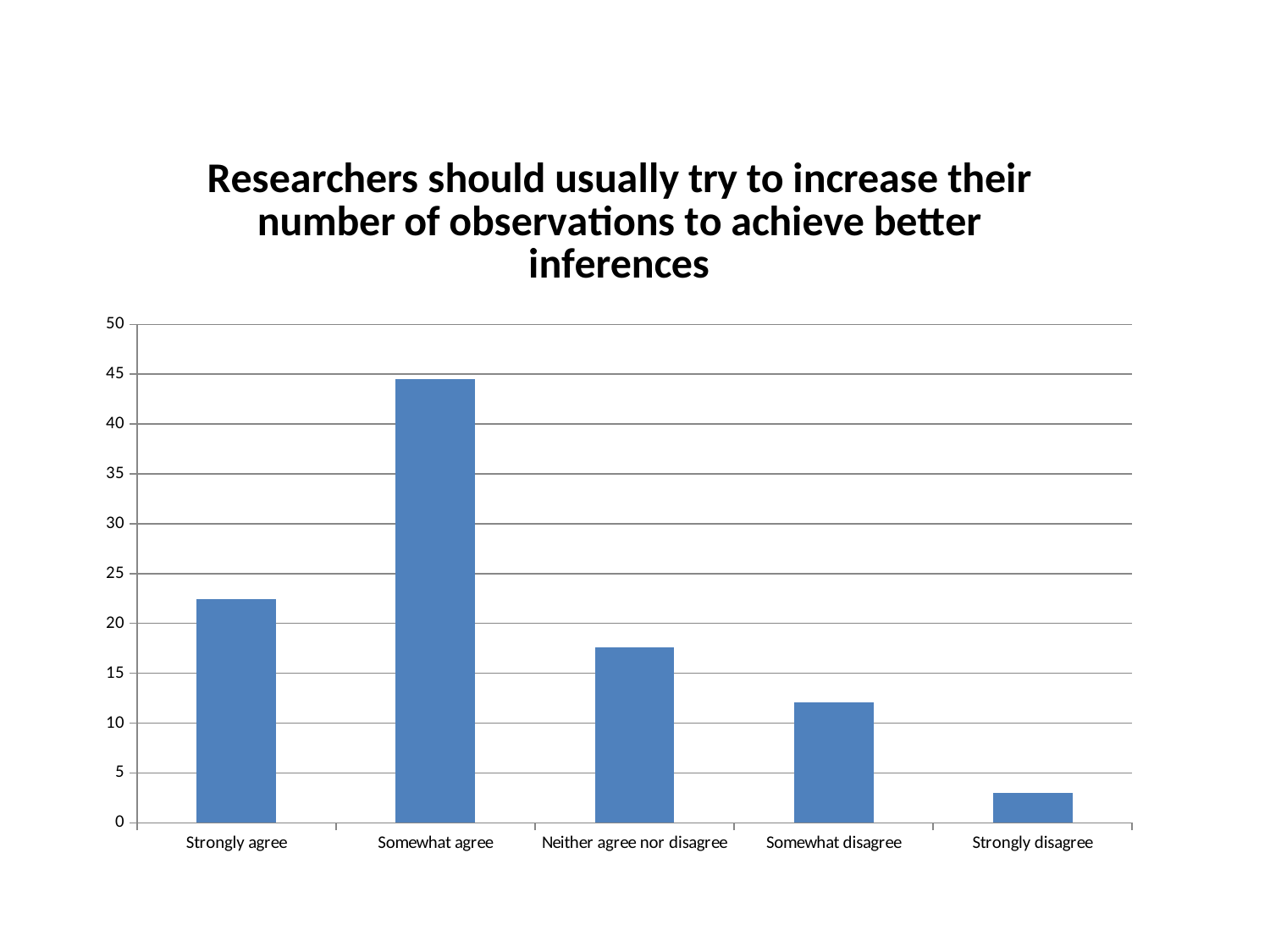
What kind of chart is shown on the slide? bar chart Is the value for Somewhat disagree greater or less than 15? less Which is larger, the value for Strongly agree or the value for Neither agree nor disagree? Strongly agree Which is larger, the value for Somewhat disagree or the value for Strongly disagree? Somewhat disagree Is the value for Strongly agree greater or less than 20? greater Which category has the highest value in the chart? Somewhat agree Is the value for Neither agree nor disagree greater or less than 20? less What is the title of the chart? Researchers should usually try to increase their number of observations to achieve better inferences Which category has the lowest value in the chart? Strongly disagree How many categories are shown on the x axis of the chart? 5